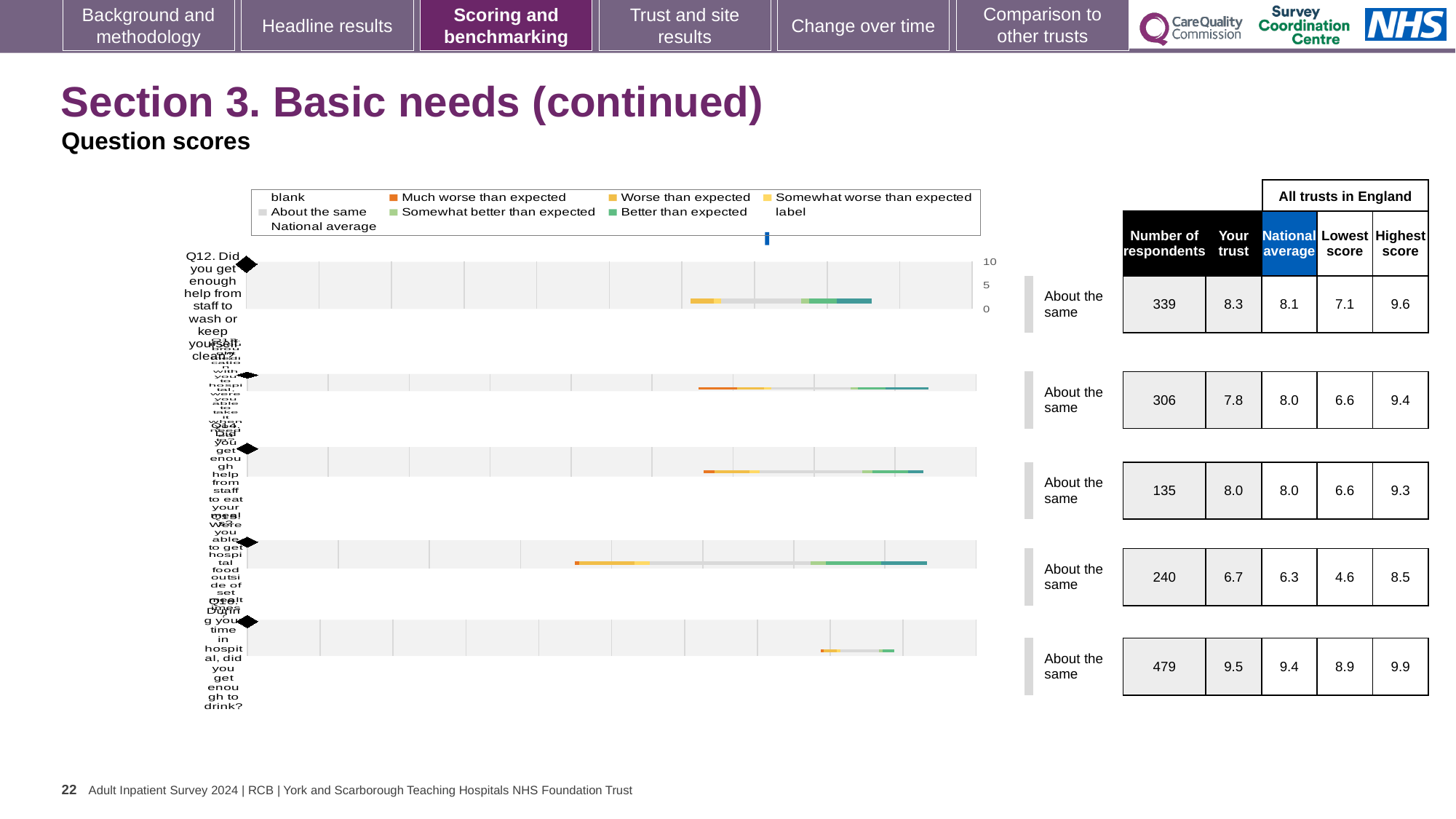
What kind of chart is shown on the slide? bar chart In the table beside the chart, is the 'Your trust' score or the national average larger for Q15 (hospital food outside of set meal times)? Your trust What is the maximum value shown on the chart's score axis? 10 In the table beside the chart, which question has the lowest 'Your trust' score? Q15 (hospital food outside of set meal times) In the table beside the chart, what is the highest score across all trusts in England for Q15 (hospital food outside of set meal times)? 8.5 In the table beside the chart, which question has the highest 'Your trust' score? Q16 (did you get enough to drink) In the table beside the chart, how many respondents answered Q12 (help from staff to wash or keep yourself clean)? 339 In the table beside the chart, what is the 'Your trust' score for Q16 (did you get enough to drink)? 9.5 According to the table beside the chart, what is the benchmark category for Q12 (help from staff to wash or keep yourself clean)? About the same How many questions (rows) are plotted in the chart? 5 In the table beside the chart, what is the difference between the 'Your trust' score and the national average for Q15 (hospital food outside of set meal times)? 0.4 Which colour does the legend use for 'Much worse than expected'? orange